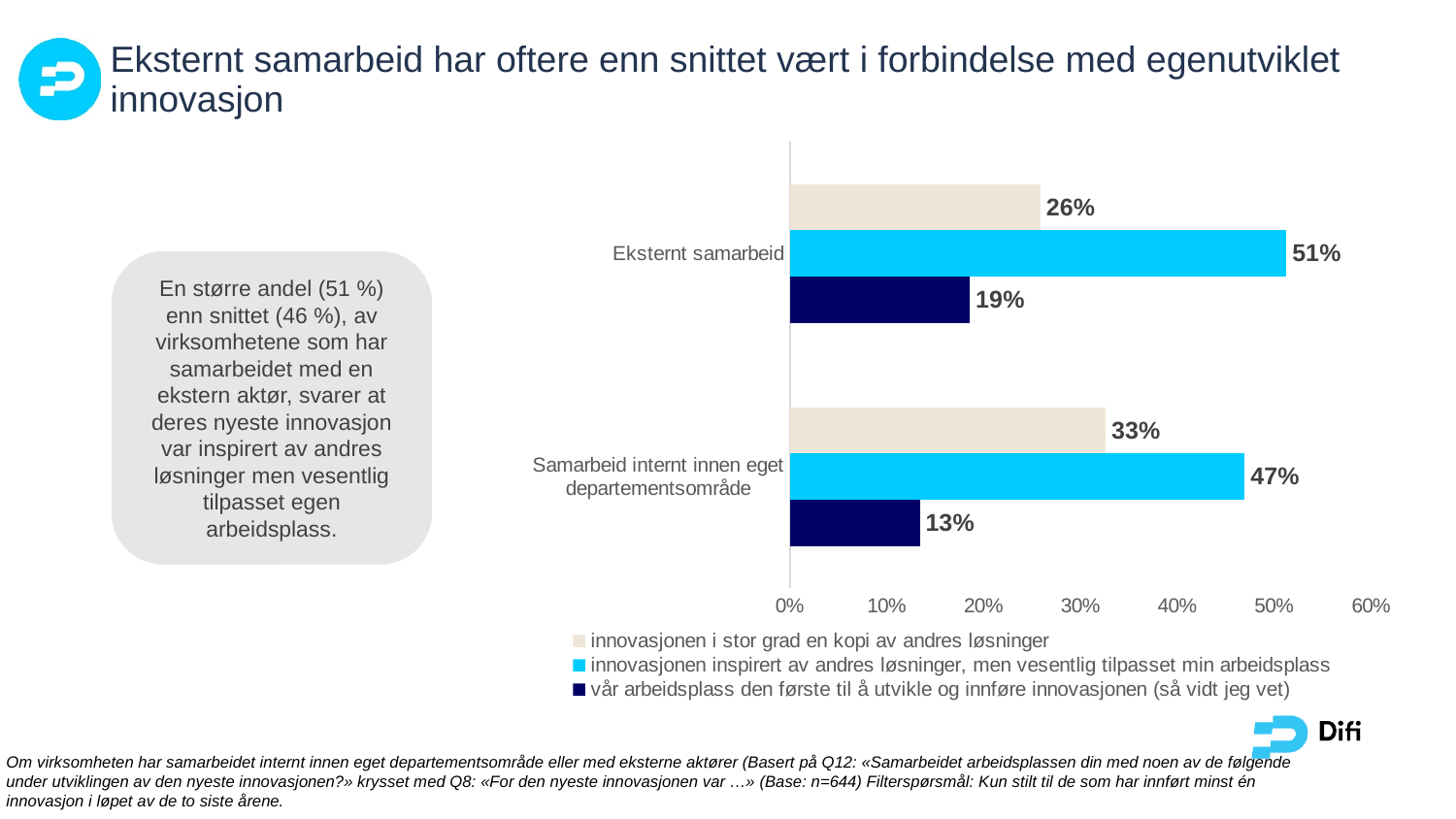
Which category has the lowest value in the series 'innovasjonen i stor grad en kopi av andres løsninger'? Eksternt samarbeid Which category has the highest value in the series 'innovasjonen inspirert av andres løsninger, men vesentlig tilpasset min arbeidsplass'? Eksternt samarbeid What is the value for 'Samarbeid internt innen eget departementsområde' in the series 'innovasjonen i stor grad en kopi av andres løsninger'? 33% What is the difference between the 'innovasjonen inspirert av andres løsninger, men vesentlig tilpasset min arbeidsplass' values for 'Eksternt samarbeid' and 'Samarbeid internt innen eget departementsområde'? 4 percentage points How many categories are shown on the chart? 2 What is the value for 'Samarbeid internt innen eget departementsområde' in the series 'vår arbeidsplass den første til å utvikle og innføre innovasjonen (så vidt jeg vet)'? 13% What is the value for 'Eksternt samarbeid' in the series 'innovasjonen inspirert av andres løsninger, men vesentlig tilpasset min arbeidsplass'? 51% What kind of chart is shown on the slide? Bar chart How many series does the legend list? 3 Which colour represents the series 'vår arbeidsplass den første til å utvikle og innføre innovasjonen (så vidt jeg vet)'? Dark blue What is the value for 'Eksternt samarbeid' in the series 'vår arbeidsplass den første til å utvikle og innføre innovasjonen (så vidt jeg vet)'? 19% Which is larger: the 'innovasjonen i stor grad en kopi av andres løsninger' value for 'Eksternt samarbeid' or for 'Samarbeid internt innen eget departementsområde'? Samarbeid internt innen eget departementsområde